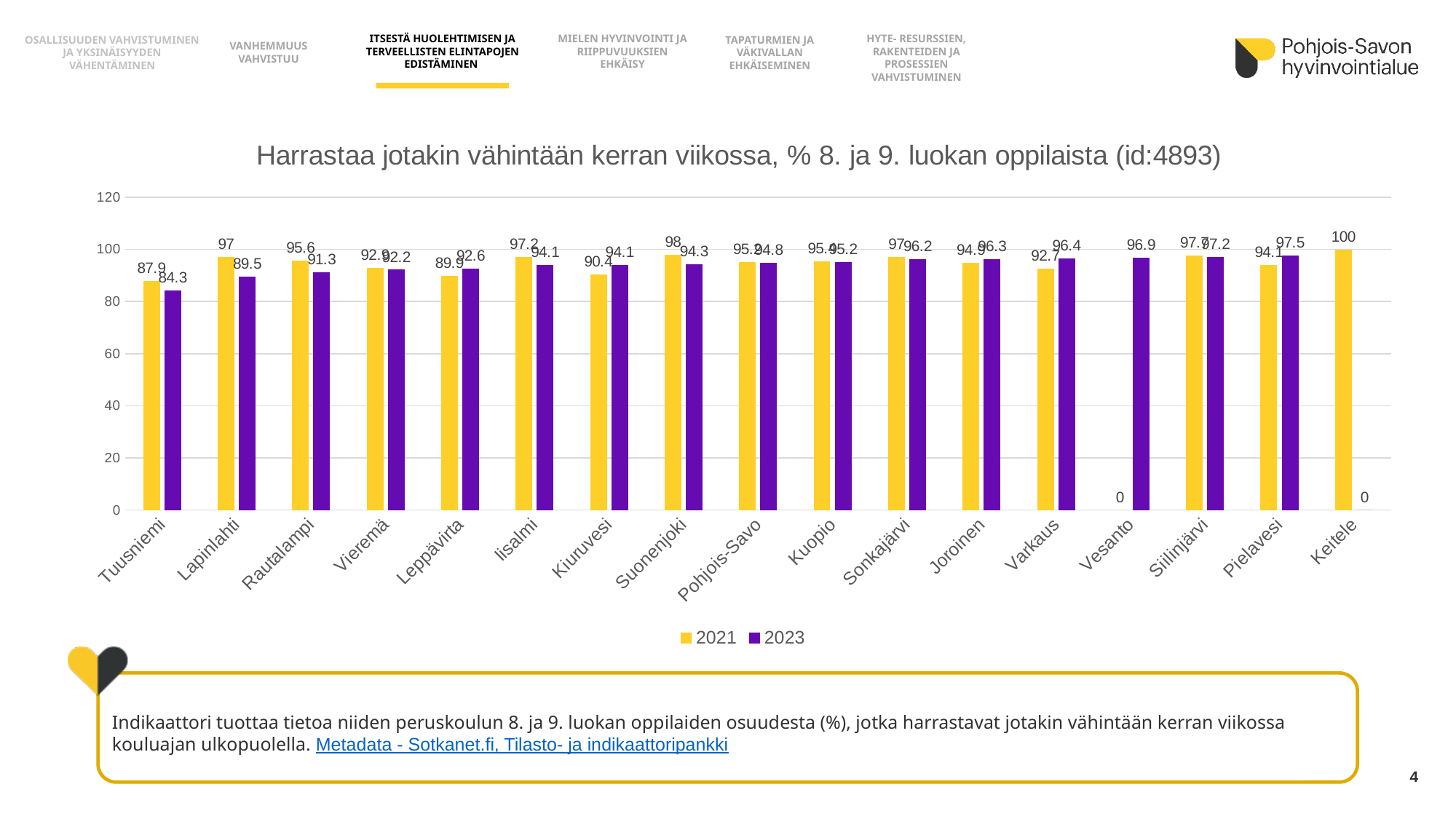
For Kiuruvesi, which year has the larger value, 2021 or 2023? 2023 What is the difference between the 2023 and 2021 values for Varkaus? 3.7 What is the difference between the 2021 and 2023 values for Lapinlahti? 7.5 How many categories are shown on the x axis? 17 Is the 2021 value for Tuusniemi greater or less than 80? greater What kind of chart is shown on the slide? bar chart What is the 2021 value for Suonenjoki? 98 What is the 2023 value for Vesanto? 96.9 Which category has the highest 2021 value? Keitele How many series does the legend list? 2 Which category has the lowest 2021 value? Vesanto What is the 2023 value for Tuusniemi? 84.3